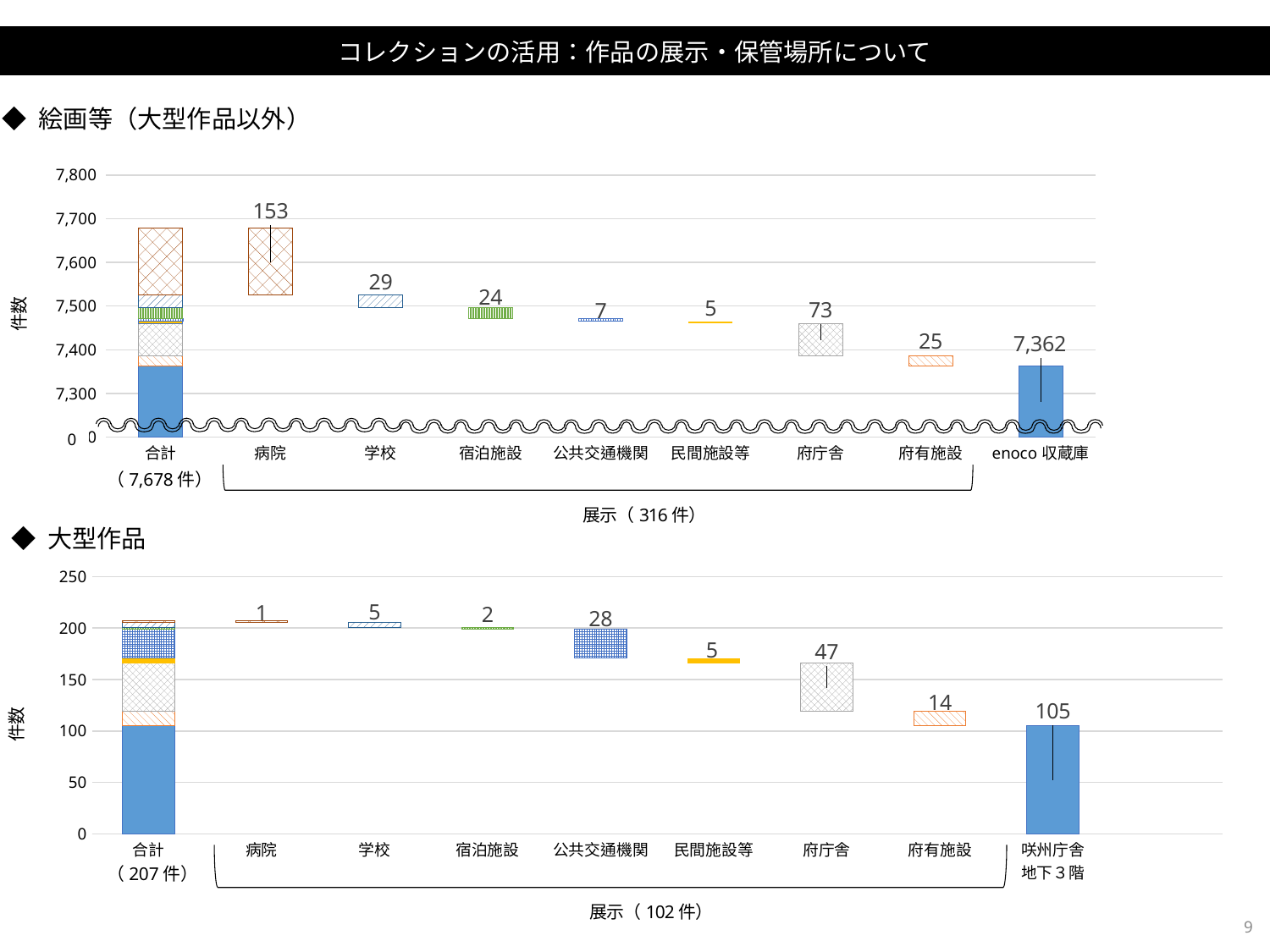
In the bottom chart (大型作品), what is the difference between the values for 府庁舎 and 府有施設? 33 In the top chart (絵画等（大型作品以外）), what is the value for 府庁舎? 73 In the top chart (絵画等（大型作品以外）), what is the value for 病院? 153 What kind of chart is the bottom chart (大型作品)? bar chart In the top chart (絵画等（大型作品以外）), what is the value for enoco 収蔵庫? 7,362 In the bottom chart (大型作品), which category has the lowest value? 病院 In the top chart (絵画等（大型作品以外）), which category has the lowest value? 民間施設等 In the top chart (絵画等（大型作品以外）), what is the difference between the values for 病院 and 府庁舎? 80 In the bottom chart (大型作品), what is the value for 公共交通機関? 28 In the bottom chart (大型作品), what is the value for 咲州庁舎地下３階? 105 In the bottom chart (大型作品), what is the total shown for 合計? 207 件 In the top chart (絵画等（大型作品以外）), which is larger, the value for 学校 or the value for 宿泊施設? 学校